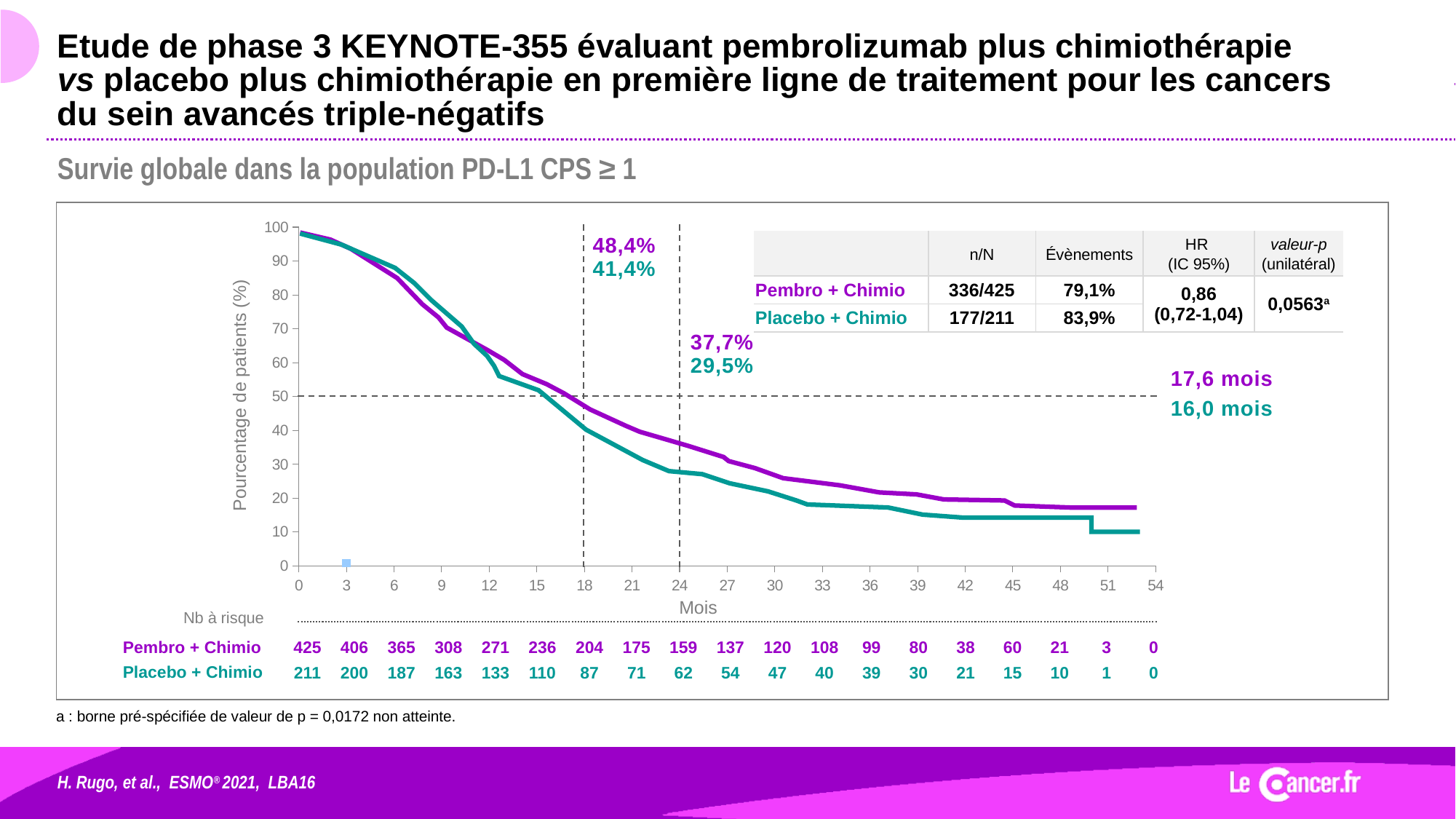
What is the label of the y axis? Pourcentage de patients (%) How many patients were at risk in the Placebo + Chimio arm at 12 months? 133 What is the overall survival rate for Pembro + Chimio at 18 months? 48,4% How many treatment arms are plotted on the chart? 2 Do the survival curves rise or fall as months increase along the x axis? Fall What is the median overall survival for the Pembro + Chimio arm? 17,6 mois What is the overall survival rate for Placebo + Chimio at 24 months? 29,5% Which arm has the higher survival rate at 18 months, Pembro + Chimio or Placebo + Chimio? Pembro + Chimio What type of chart is shown on the slide? Line chart (Kaplan-Meier survival curve) What is the difference between the 24-month survival rates of Pembro + Chimio and Placebo + Chimio? 8,2% How many patients were at risk in the Pembro + Chimio arm at 24 months? 159 What is the hazard ratio (95% CI) reported in the table? 0,86 (0,72-1,04)